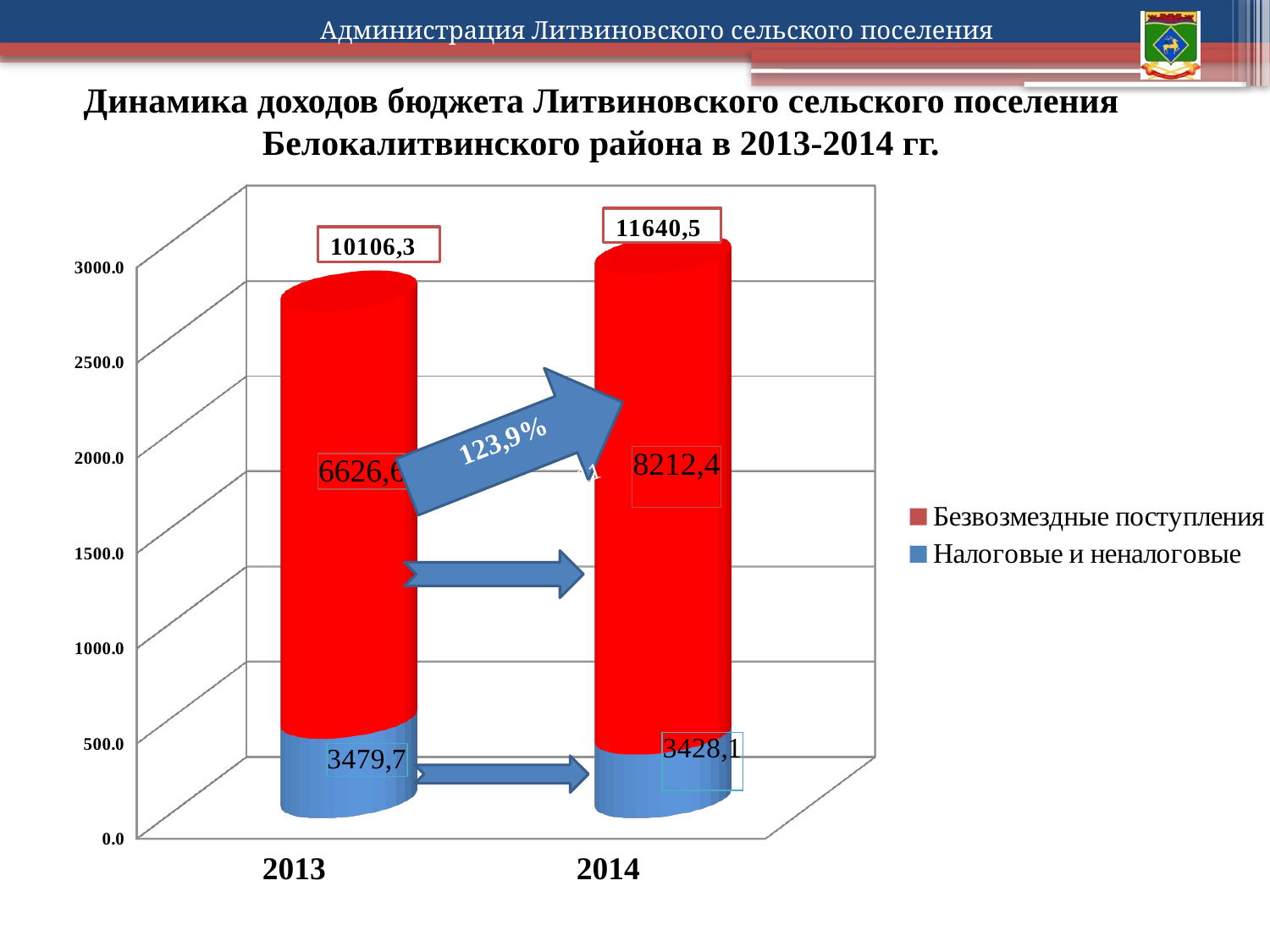
What is the value of Налоговые и неналоговые for 2014? 3428,1 What is the total of the stacked bar for 2014? 11640,5 How many series does the chart legend list? 2 What is the difference between the total for 2014 and the total for 2013? 1534,2 Which year has the larger value for Налоговые и неналоговые, 2013 or 2014? 2013 What kind of chart is shown on the slide? bar chart What is the total of the stacked bar for 2013? 10106,3 What percentage is written on the large arrow between the two bars? 123,9% How many years (categories) are shown on the x axis of the chart? 2 What is the value of Безвозмездные поступления for 2014? 8212,4 What is the value of Налоговые и неналоговые for 2013? 3479,7 Which year has the higher total budget income, 2013 or 2014? 2014